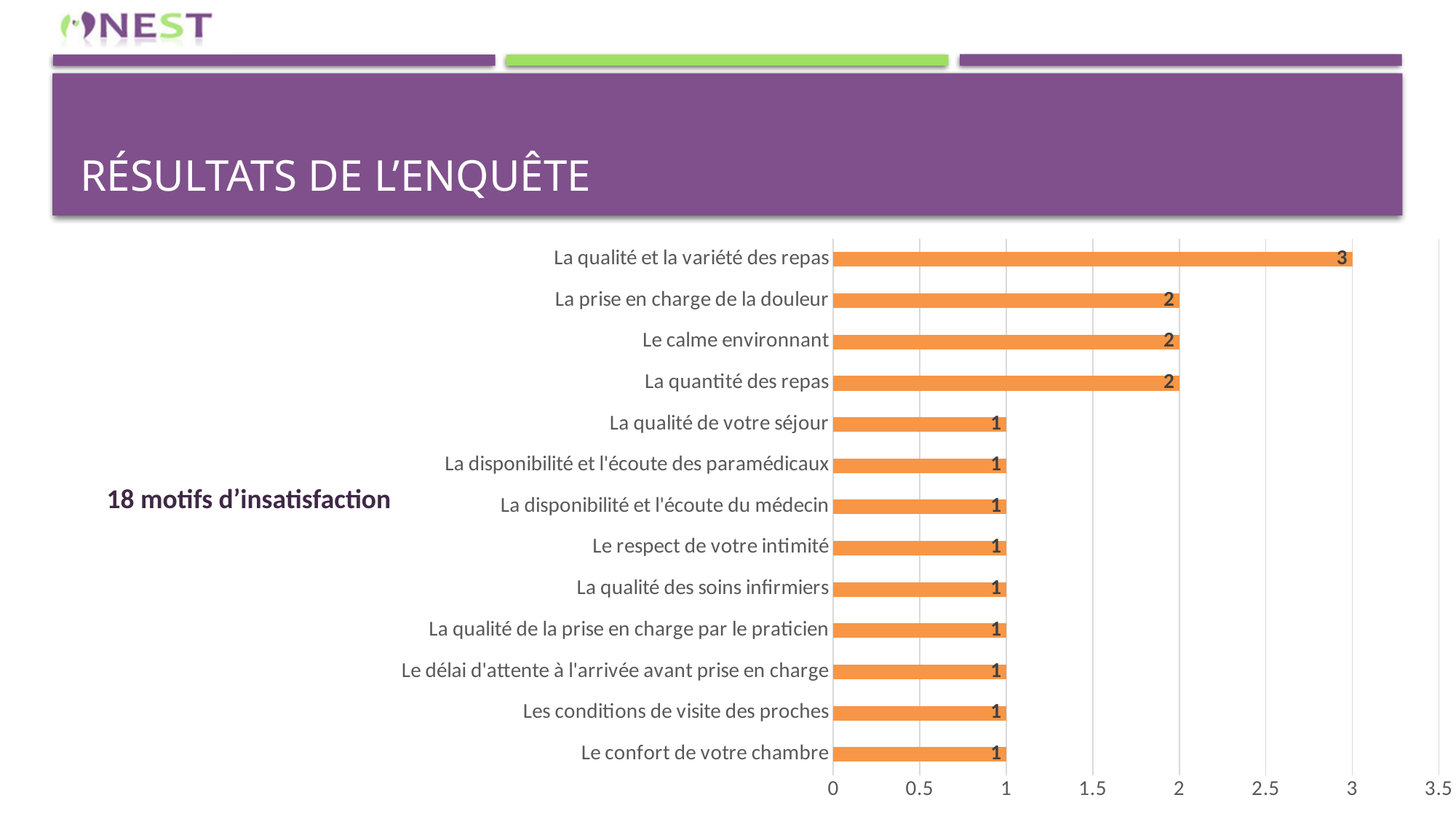
What is the value for "La qualité et la variété des repas"? 3 What is the highest value shown on the horizontal axis? 3.5 How many categories are shown in the chart? 13 What is the difference between the values for "La qualité et la variété des repas" and "La qualité de votre séjour"? 2 What is the value for "La prise en charge de la douleur"? 2 Which category has the highest value? La qualité et la variété des repas What is the difference between the values for "La qualité et la variété des repas" and "Le calme environnant"? 1 Is the value for "La qualité et la variété des repas" greater or less than 2.5? greater What kind of chart is shown on the slide? bar chart Which is larger, the value for "La prise en charge de la douleur" or the value for "Les conditions de visite des proches"? La prise en charge de la douleur What is the value for "La quantité des repas"? 2 What is the value for "Le confort de votre chambre"? 1